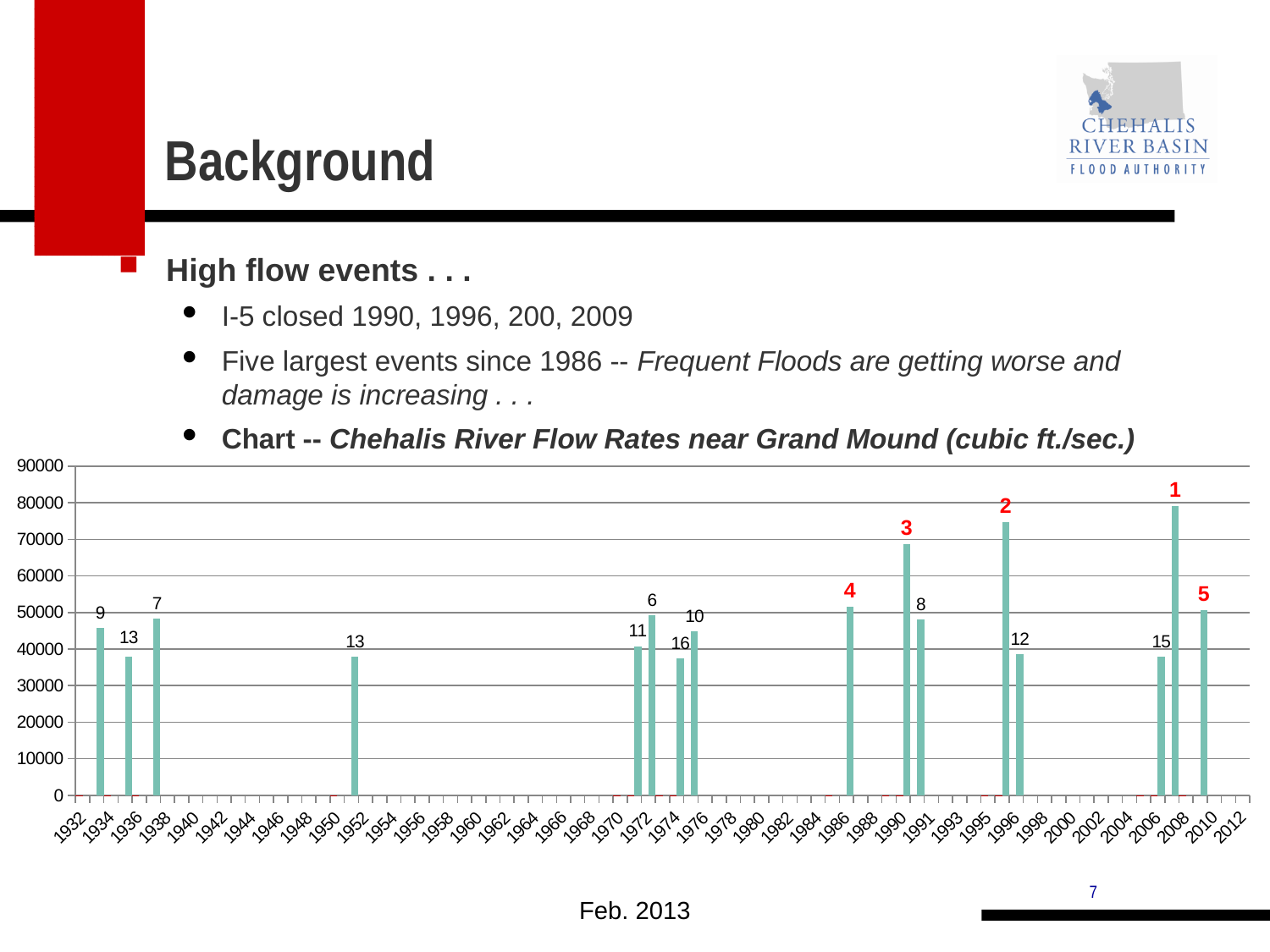
Which rank label marks the tallest bar on the chart? 1 Which is larger, the bar labeled 2 or the bar labeled 5? the bar labeled 2 Is the value of the bar labeled 9 greater or less than 40000? greater How many bars on the chart have their rank label printed in red? 5 Which is larger, the bar labeled 3 or the bar labeled 8? the bar labeled 3 Which rank label marks the shortest bar on the chart? 16 What kind of chart is shown on the slide? bar chart How many bars (high flow events) are plotted on the chart? 16 Is the value of the bar labeled 16 greater or less than 40000? less Is the value of the bar labeled 2 greater or less than 70000? greater What is the title of the chart given in the bullet text? Chehalis River Flow Rates near Grand Mound (cubic ft./sec.)